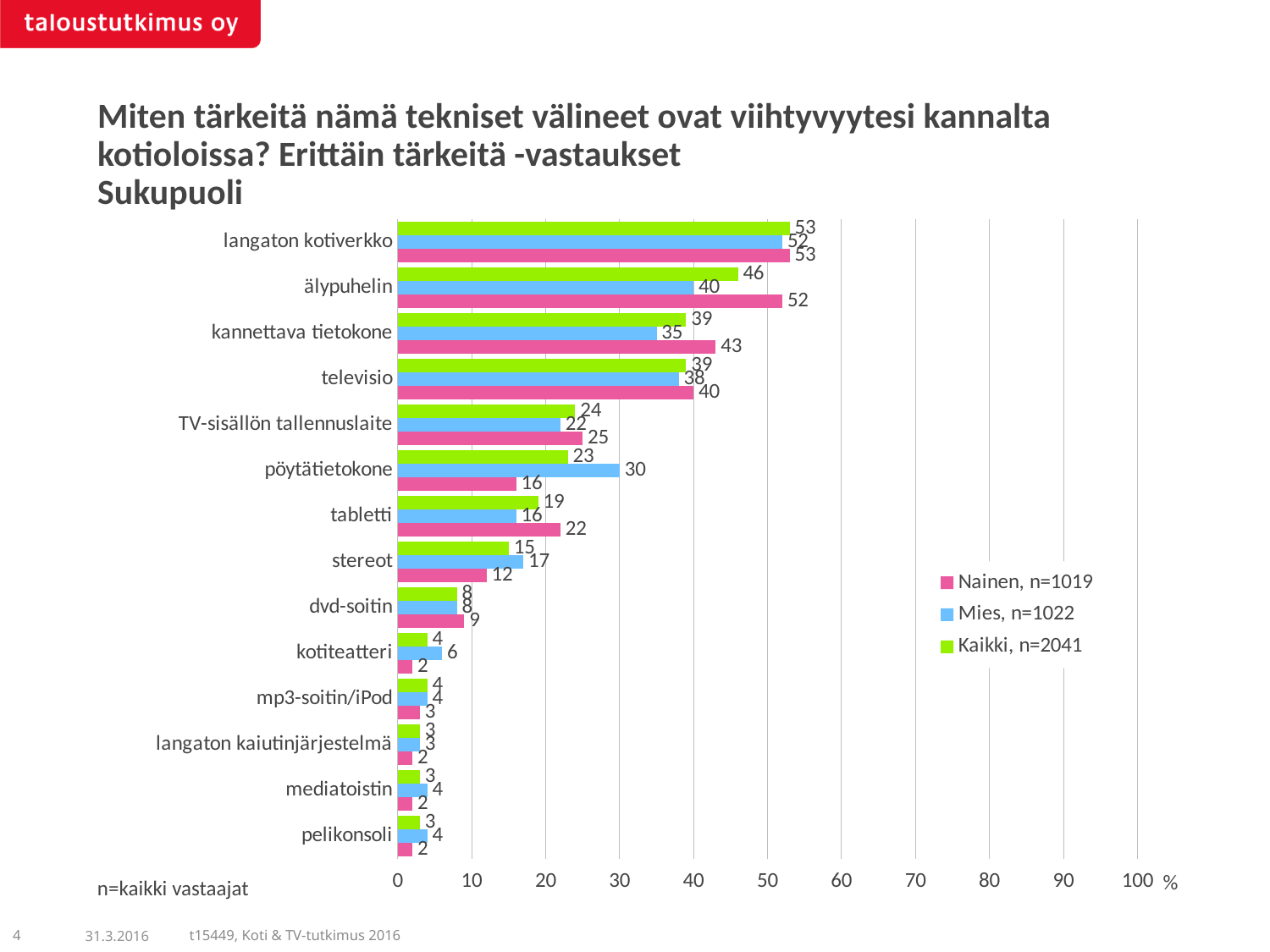
Which category has the highest value for the Kaikki series? langaton kotiverkko How many series does the legend list? 3 For stereot, which is larger: the Nainen value or the Mies value? Mies How many categories are shown on the chart? 14 Which category has the lowest value for the Mies series? langaton kaiutinjärjestelmä What is the value for Nainen for älypuhelin? 52 What kind of chart is shown on the slide? bar chart What is the value for Kaikki for kannettava tietokone? 39 What is the value for Mies for pöytätietokone? 30 What is the difference between the Nainen and Mies values for pöytätietokone? 14 Which legend entry has n=1022? Mies Is the Nainen value for kannettava tietokone greater or less than 40? greater